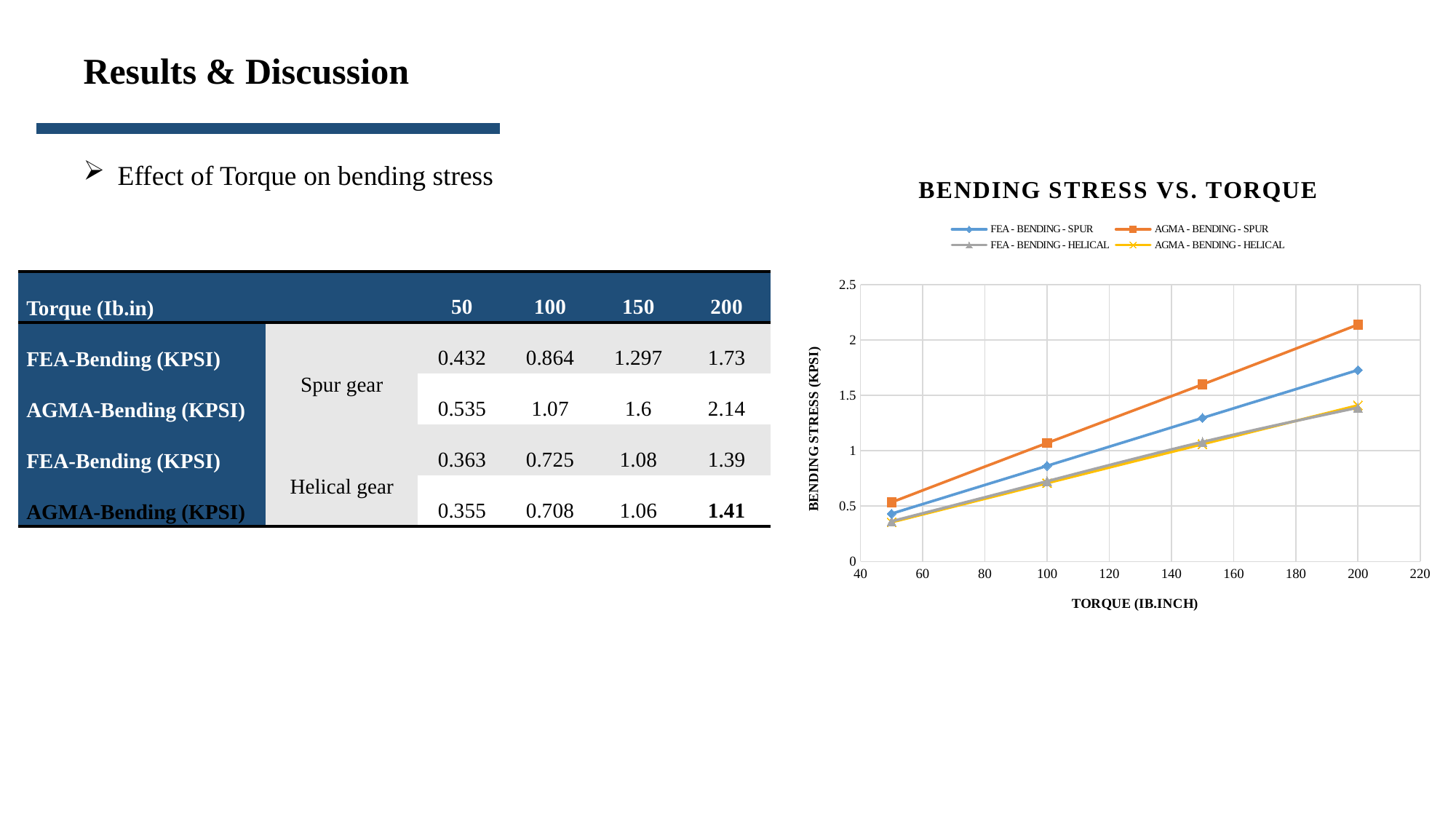
According to the slide, what is the difference between the AGMA and FEA bending stress for the spur gear at a torque of 200 lb.in? 0.41 In the "BENDING STRESS VS. TORQUE" chart, does bending stress rise or fall as torque increases? rise What is the x-axis title of the "BENDING STRESS VS. TORQUE" chart? TORQUE (IB.INCH) What kind of chart is shown under the title "BENDING STRESS VS. TORQUE"? line chart According to the slide, what is the AGMA bending stress (KPSI) for the spur gear at a torque of 200 lb.in? 2.14 In the "BENDING STRESS VS. TORQUE" chart, is the value for AGMA - BENDING - SPUR at a torque of 200 greater or less than 2? greater How many torque points are plotted for each series in the "BENDING STRESS VS. TORQUE" chart? 4 In the "BENDING STRESS VS. TORQUE" chart, at a torque of 150, which is larger: FEA - BENDING - SPUR or AGMA - BENDING - SPUR? AGMA - BENDING - SPUR In the "BENDING STRESS VS. TORQUE" chart, is the value for FEA - BENDING - SPUR at a torque of 150 greater or less than 1.5? less How many series does the legend of the "BENDING STRESS VS. TORQUE" chart list? 4 In the "BENDING STRESS VS. TORQUE" chart, which series has the highest bending stress at a torque of 200? AGMA - BENDING - SPUR According to the slide, what is the FEA bending stress (KPSI) for the spur gear at a torque of 50 lb.in? 0.432